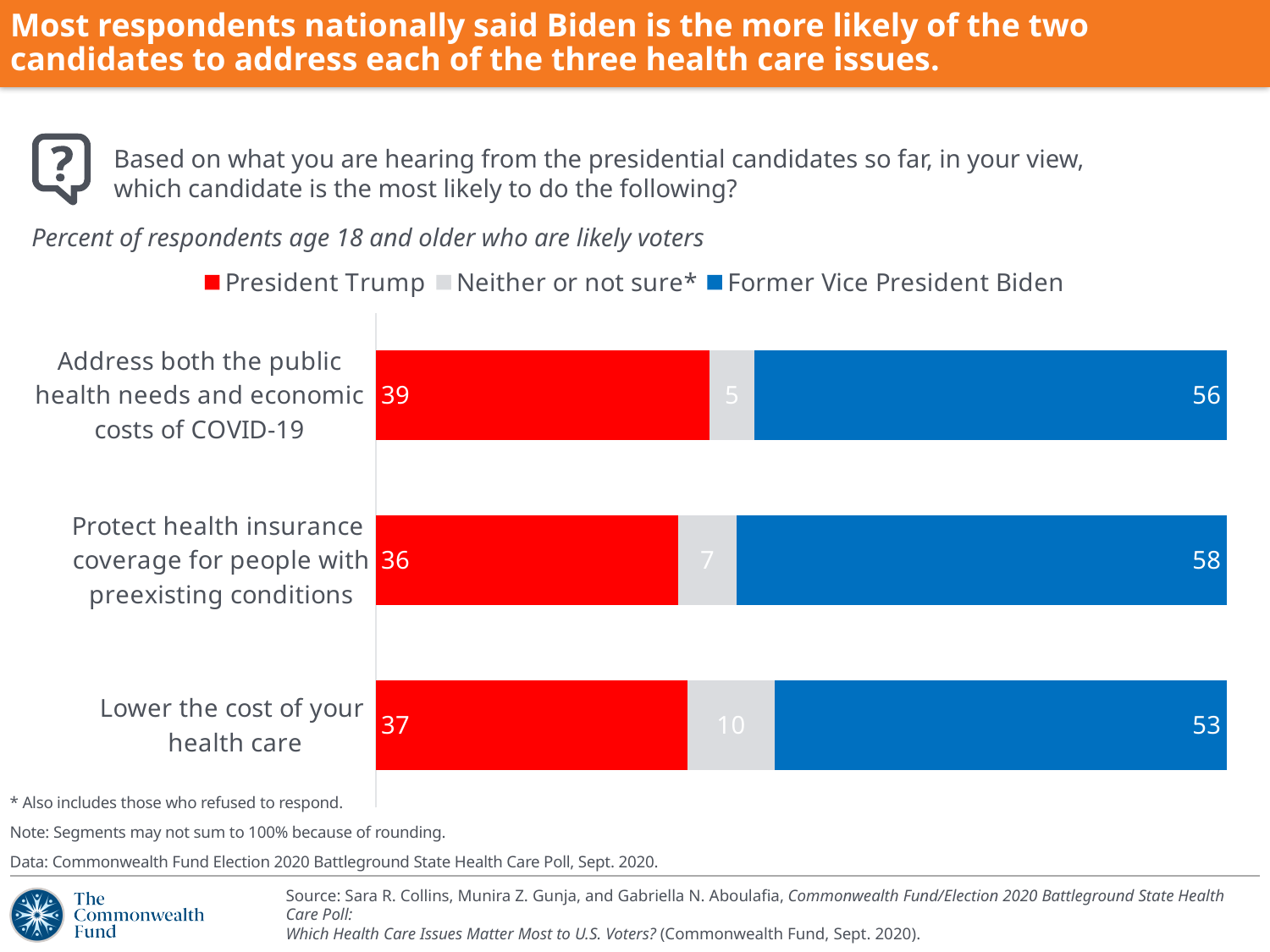
What percentage of respondents said Former Vice President Biden is most likely to protect health insurance coverage for people with preexisting conditions? 58 What percentage of respondents answered 'Neither or not sure' for addressing both the public health needs and economic costs of COVID-19? 5 For which issue did Former Vice President Biden receive the highest percentage? Protect health insurance coverage for people with preexisting conditions Which is larger for addressing COVID-19: the percentage for President Trump or for Former Vice President Biden? Former Vice President Biden For which issue did President Trump receive the lowest percentage? Protect health insurance coverage for people with preexisting conditions What is the total of the three segments for the 'Lower the cost of your health care' bar? 100 Which colour represents Former Vice President Biden in the chart? Blue How many series does the legend list? 3 What percentage of respondents said President Trump is most likely to lower the cost of their health care? 37 What is the difference between the Biden and Trump percentages for lowering the cost of your health care? 16 What kind of chart is shown on the slide? Stacked bar chart How many health care issues are shown in the chart? 3